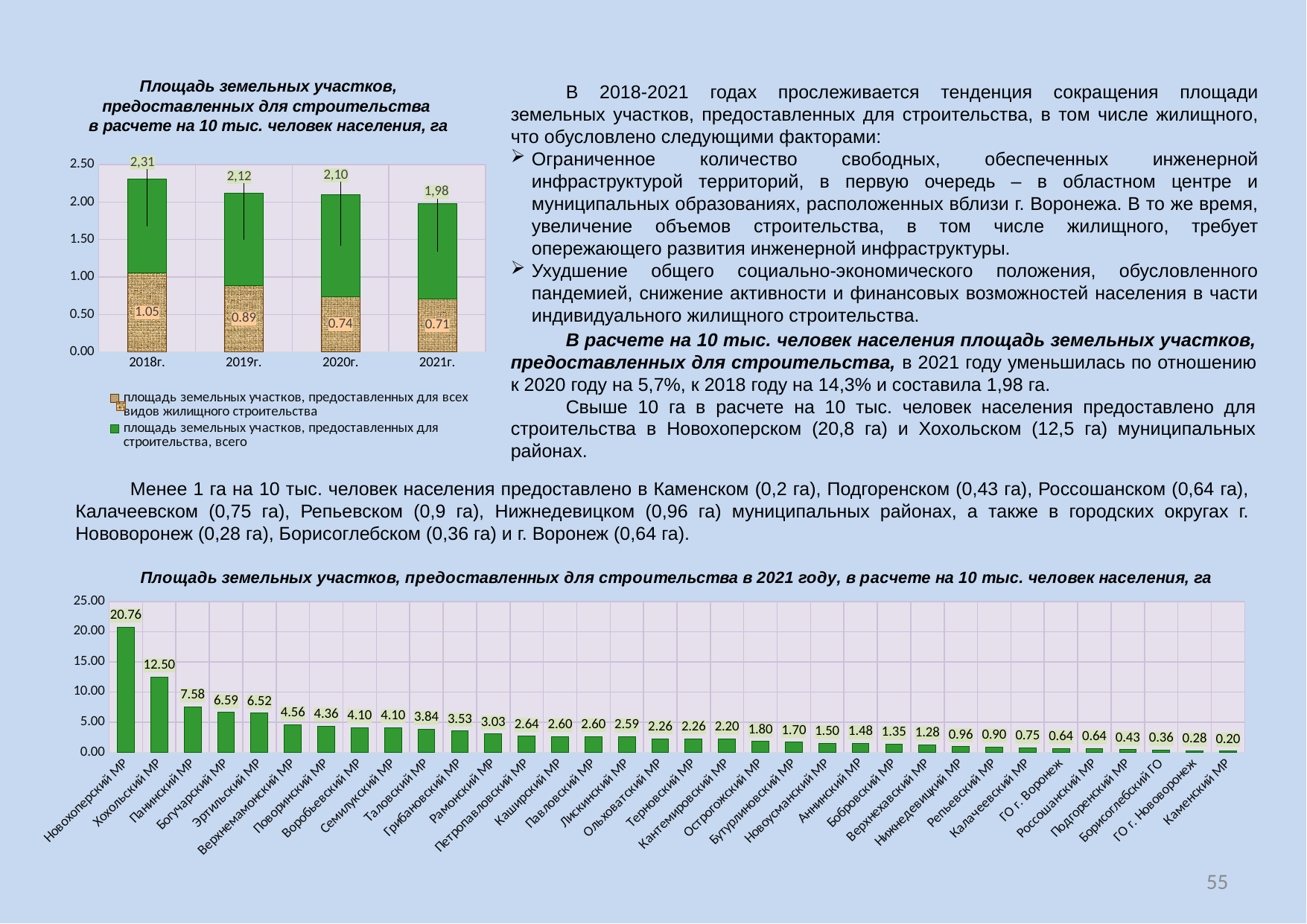
In the top-left chart, what is the difference between the total values for 2018г. and 2021г.? 0,33 In the top-left chart (Площадь земельных участков, предоставленных для строительства в расчете на 10 тыс. человек населения), what is the total value (green bar) for 2021г.? 1,98 In the bottom chart, which is larger: the value for Панинский МР or the value for Богучарский МР? Панинский МР In the bottom chart, what is the difference between the values for Новохоперский МР and Хохольский МР? 8.26 In the bottom chart, which district has the lowest value? Каменский МР In the top-left chart, which year has the highest total value (green bar)? 2018г. What kind of chart is the bottom chart? bar chart In the top-left chart, how many series does the legend list? 2 In the top-left chart, do the housing construction values (tan bars) rise or fall from 2018г. to 2021г.? fall In the top-left chart, what is the value for housing construction (tan bar) in 2018г.? 1.05 In the bottom chart (Площадь земельных участков, предоставленных для строительства в 2021 году), what is the value for Хохольский МР? 12.50 In the bottom chart, which district has the highest value? Новохоперский МР